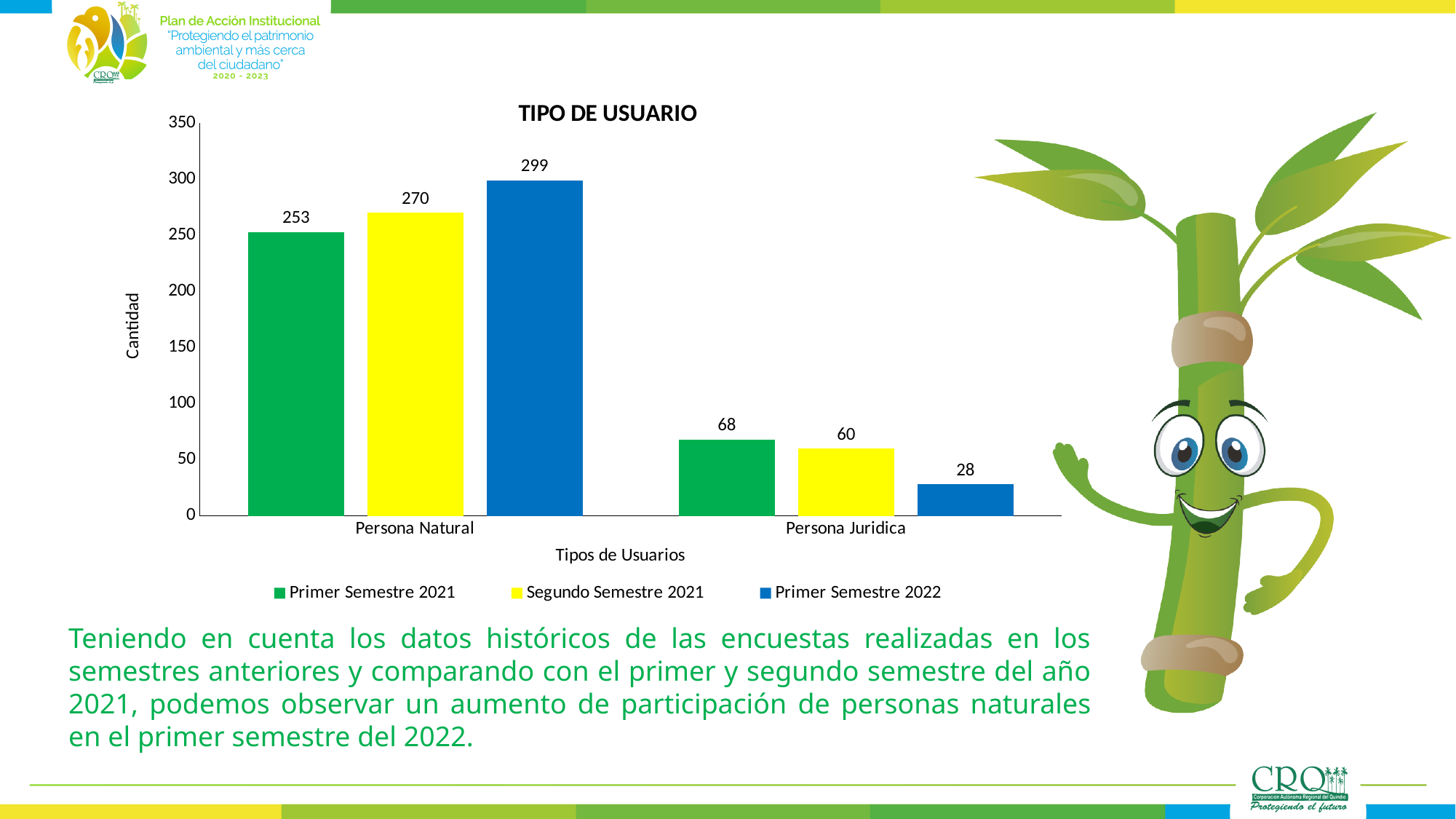
Is the value for Persona Natural in Segundo Semestre 2021 greater or less than 250? greater What is the value for Persona Natural in Primer Semestre 2022? 299 How many categories are shown on the x axis? 2 Which is larger: Persona Juridica in Primer Semestre 2021 or Persona Juridica in Segundo Semestre 2021? Primer Semestre 2021 What is the value for Persona Juridica in Segundo Semestre 2021? 60 What is the value for Persona Natural in Primer Semestre 2021? 253 How many series does the legend list? 3 Which series has the lowest value for Persona Juridica? Primer Semestre 2022 What is the difference between the Persona Juridica values for Primer Semestre 2021 and Primer Semestre 2022? 40 What is the difference between the Persona Natural values for Primer Semestre 2022 and Primer Semestre 2021? 46 Which series has the highest value for Persona Natural? Primer Semestre 2022 What kind of chart is shown on the slide? Bar chart